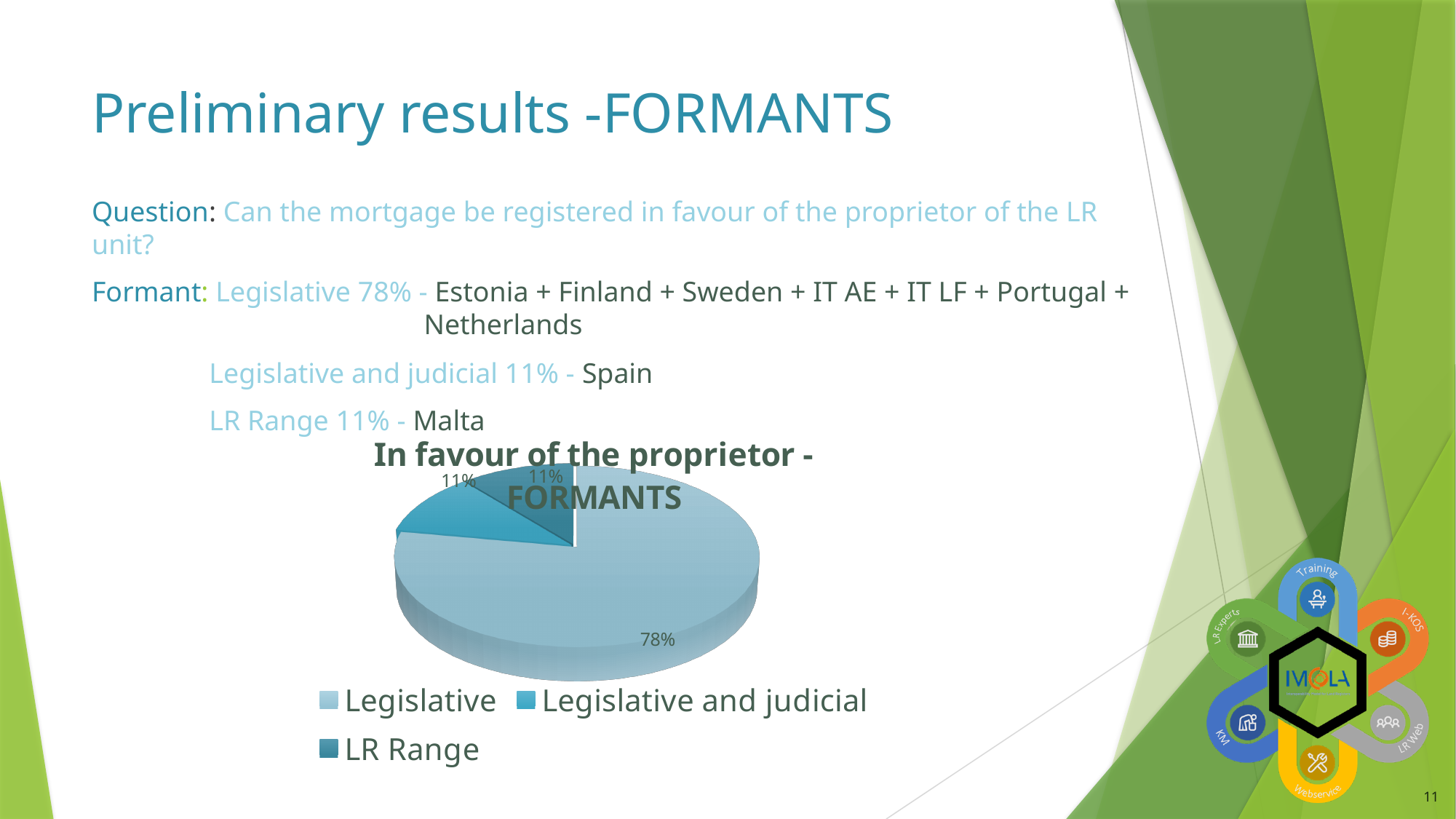
Which category has the largest slice of the pie? Legislative Which is larger, the Legislative slice or the Legislative and judicial slice? Legislative What is the value shown for LR Range in the pie chart? 11% What is the value shown for Legislative and judicial in the pie chart? 11% How many entries does the chart legend list? 3 What are the three categories listed in the chart legend? Legislative, Legislative and judicial, LR Range How many slices does the pie chart have? 3 What share of the pie does the Legislative slice represent? 78% What type of chart is shown on the slide? pie chart What is the title of the chart? In favour of the proprietor - FORMANTS What is the difference in percentage points between the Legislative slice and the LR Range slice? 67 percentage points Is the value for Legislative greater or less than 50%? greater